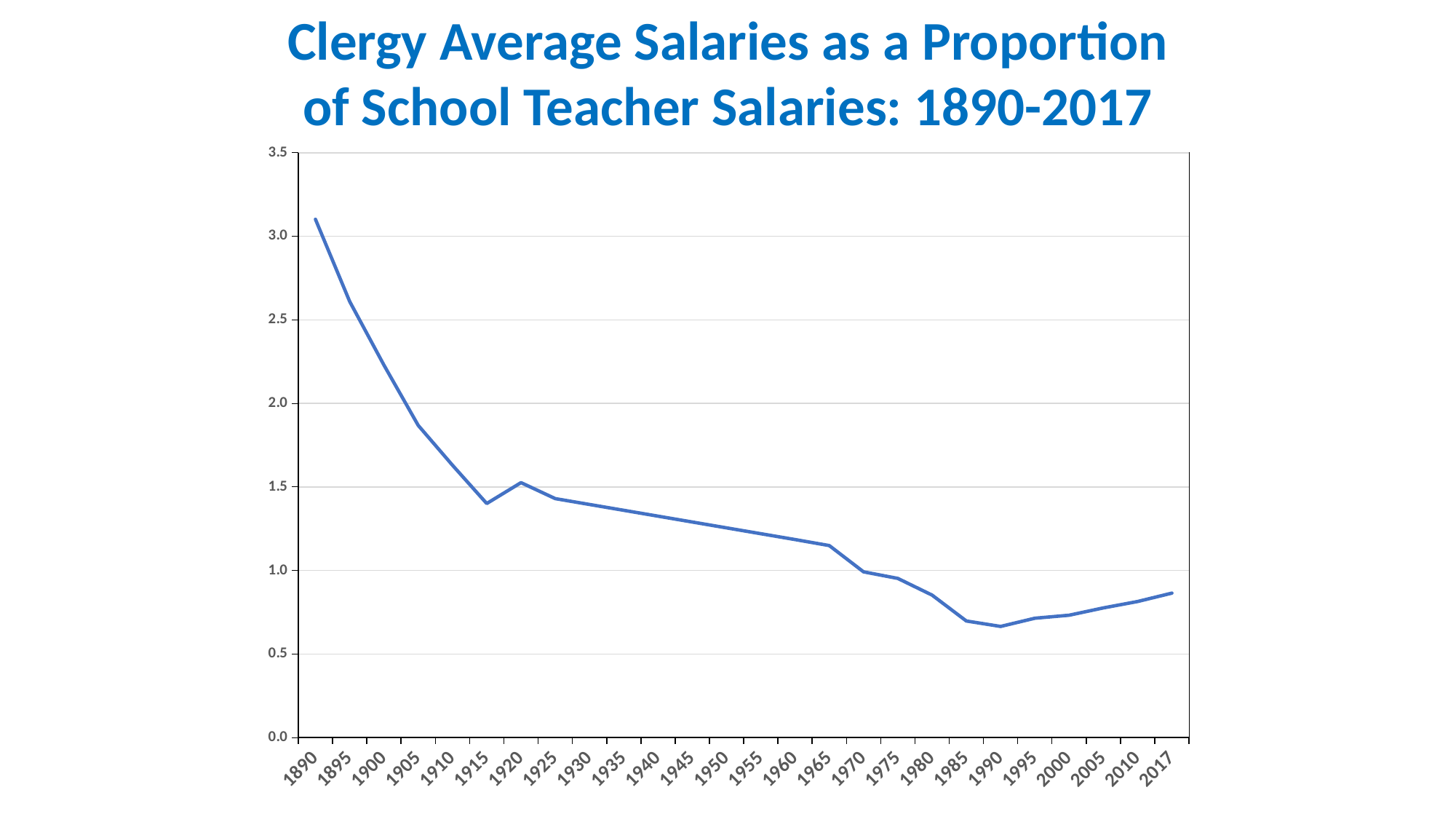
What is the title of the chart? Clergy Average Salaries as a Proportion of School Teacher Salaries: 1890-2017 Is the value for 1965 greater or less than 1.0? greater Is the value for 1890 greater or less than 2.5? greater Do the values rise or fall between 1990 and 2017? rise Is the value for 2017 greater or less than 1.0? less How many years are labelled along the x axis? 26 Which year has the highest value? 1890 Which is larger, the value for 1915 or the value for 1920? 1920 Which year has the lowest value? 1990 What kind of chart is shown on the slide? line chart Do the values rise or fall between 1890 and 1915? fall